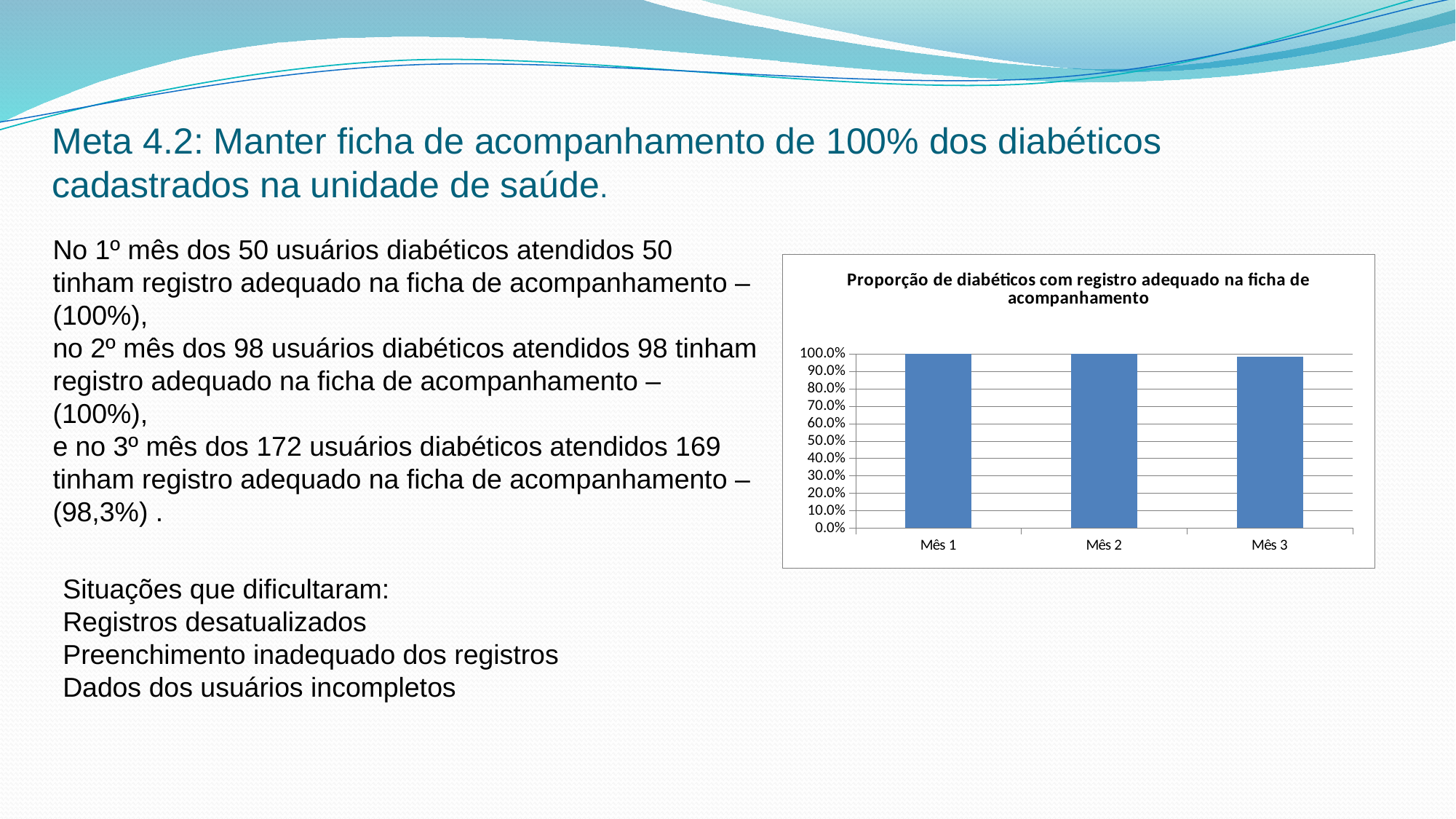
What is the value for Mês 2 in the chart? 100.0% Which month has the lowest value in the chart? Mês 3 How many categories (months) are plotted on the x axis of the chart? 3 What is the highest tick value shown on the y axis of the chart? 100.0% Is the value for Mês 3 greater or less than 90.0%? greater What is the label of the first category on the x axis? Mês 1 What is the value for Mês 1 in the chart? 100.0% What is the title of the chart? Proporção de diabéticos com registro adequado na ficha de acompanhamento Is the value for Mês 1 greater or less than 50.0%? greater What kind of chart is shown on the slide? bar chart Which is larger, the value for Mês 1 or the value for Mês 3? Mês 1